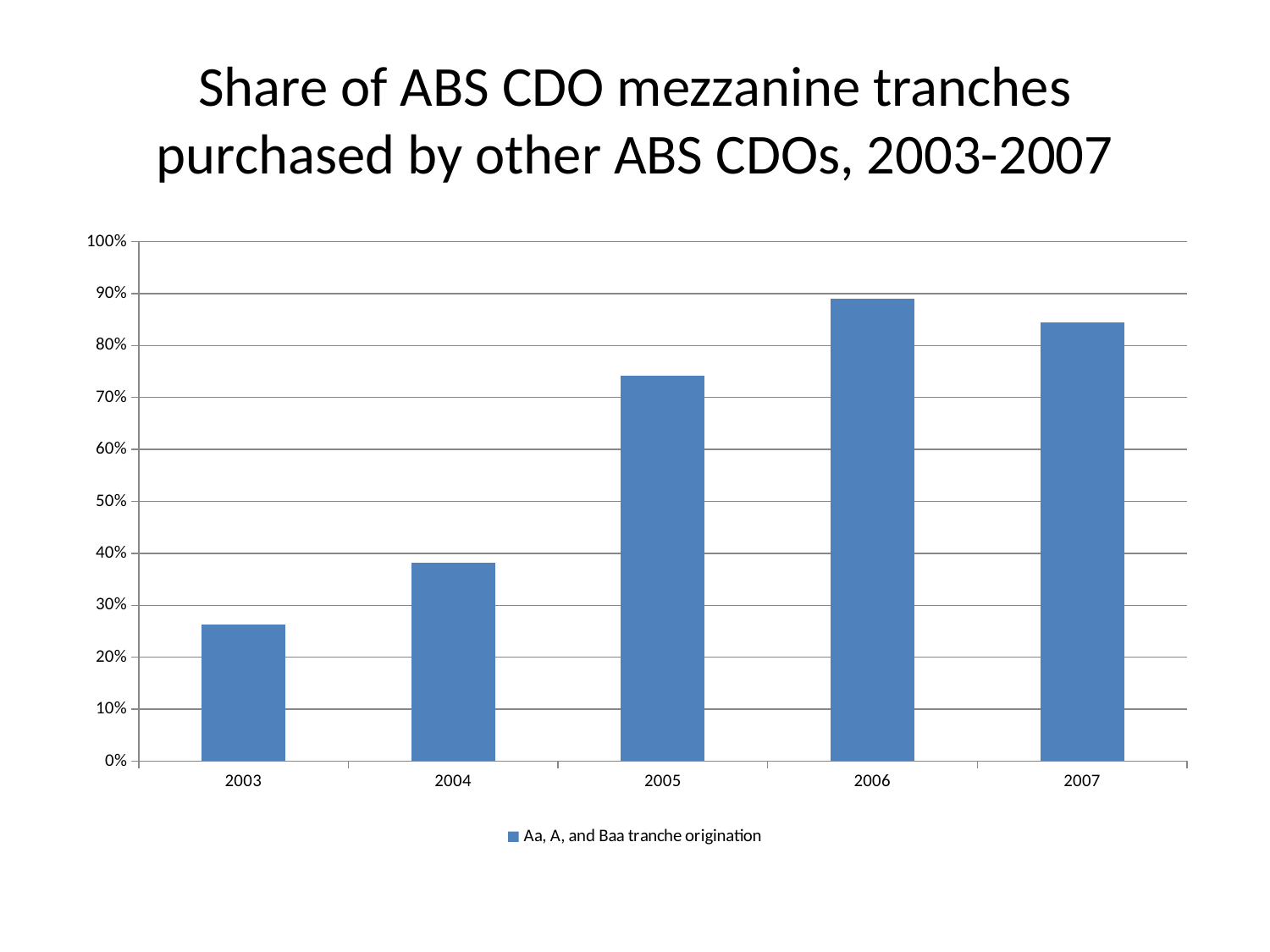
Is the value for 2003 greater or less than 30%? less Which year has the larger value, 2006 or 2007? 2006 What kind of chart is shown on the slide? bar chart Do the values rise or fall from 2003 to 2006? rise Is the value for 2007 greater or less than 80%? greater What is the name of the series listed in the legend? Aa, A, and Baa tranche origination How many series does the legend list? 1 Which year has the highest share of ABS CDO mezzanine tranches purchased by other ABS CDOs? 2006 Is the value for 2004 greater or less than 40%? less How many years are shown on the x axis of the chart? 5 Which year has the lowest share of ABS CDO mezzanine tranches purchased by other ABS CDOs? 2003